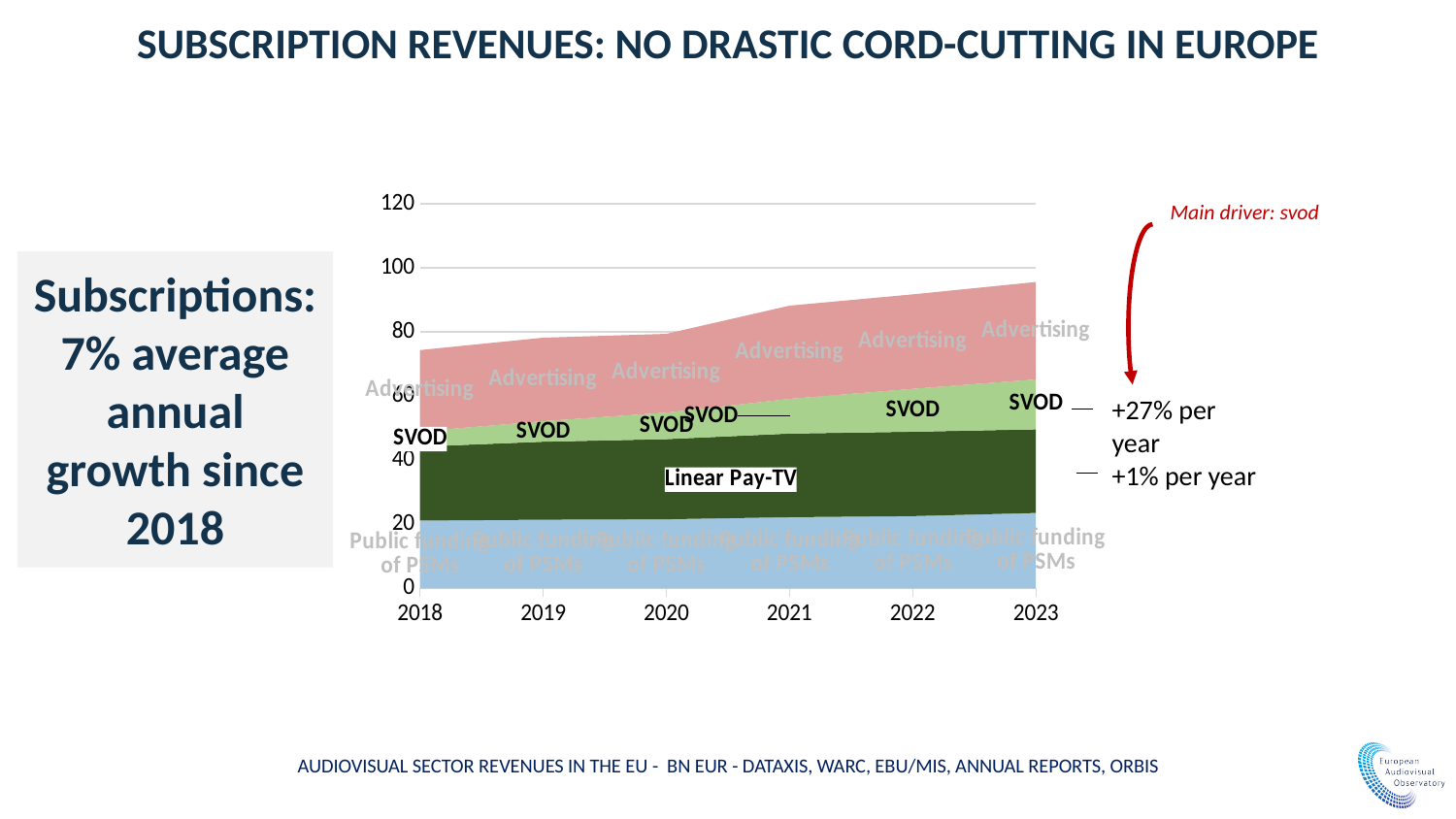
Does the total stacked revenue rise or fall from 2018 to 2023? Rise Is the total stacked revenue in 2023 greater or less than 100? less Which year is the last on the x axis of the chart? 2023 According to the annotation, what is the annual growth rate of Linear Pay-TV? +1% per year Is the total stacked revenue in 2023 greater or less than 80? greater What kind of chart is shown on the slide? Stacked area chart Which year has the higher total stacked revenue, 2018 or 2023? 2023 Is the total stacked revenue in 2018 greater or less than 80? less According to the annotation, what is the annual growth rate of SVOD? +27% per year How many years are shown on the x axis of the chart? 6 How many revenue categories are stacked in the chart? 4 Which year is the first on the x axis of the chart? 2018